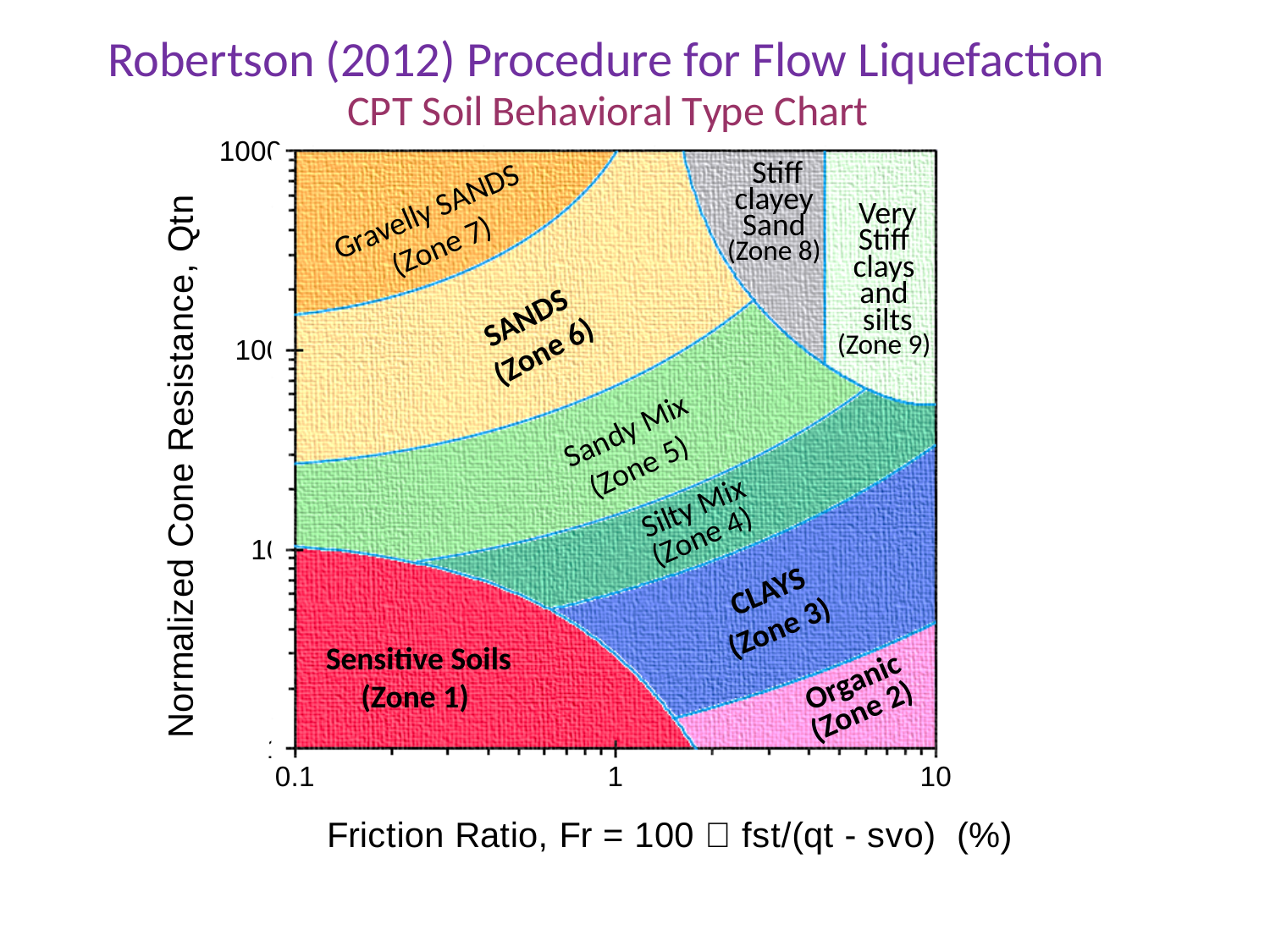
What is the lowest tick value shown on the x axis? 0.1 What soil type is labeled for Zone 9? Very Stiff clays and silts What is the label of the y axis? Normalized Cone Resistance, Qtn What soil type is labeled for Zone 3? CLAYS What soil type is labeled for Zone 7? Gravelly SANDS What is the highest tick value shown on the y axis? 1000 Which zone is labeled "Organic"? Zone 2 How many soil behavior zones are labeled on the chart? 9 What is the title of the chart? CPT Soil Behavioral Type Chart Which zone is labeled "Sensitive Soils"? Zone 1 Which zone lies between the Sandy Mix (Zone 5) region and the CLAYS (Zone 3) region? Silty Mix (Zone 4) What soil type is labeled for Zone 8? Stiff clayey Sand